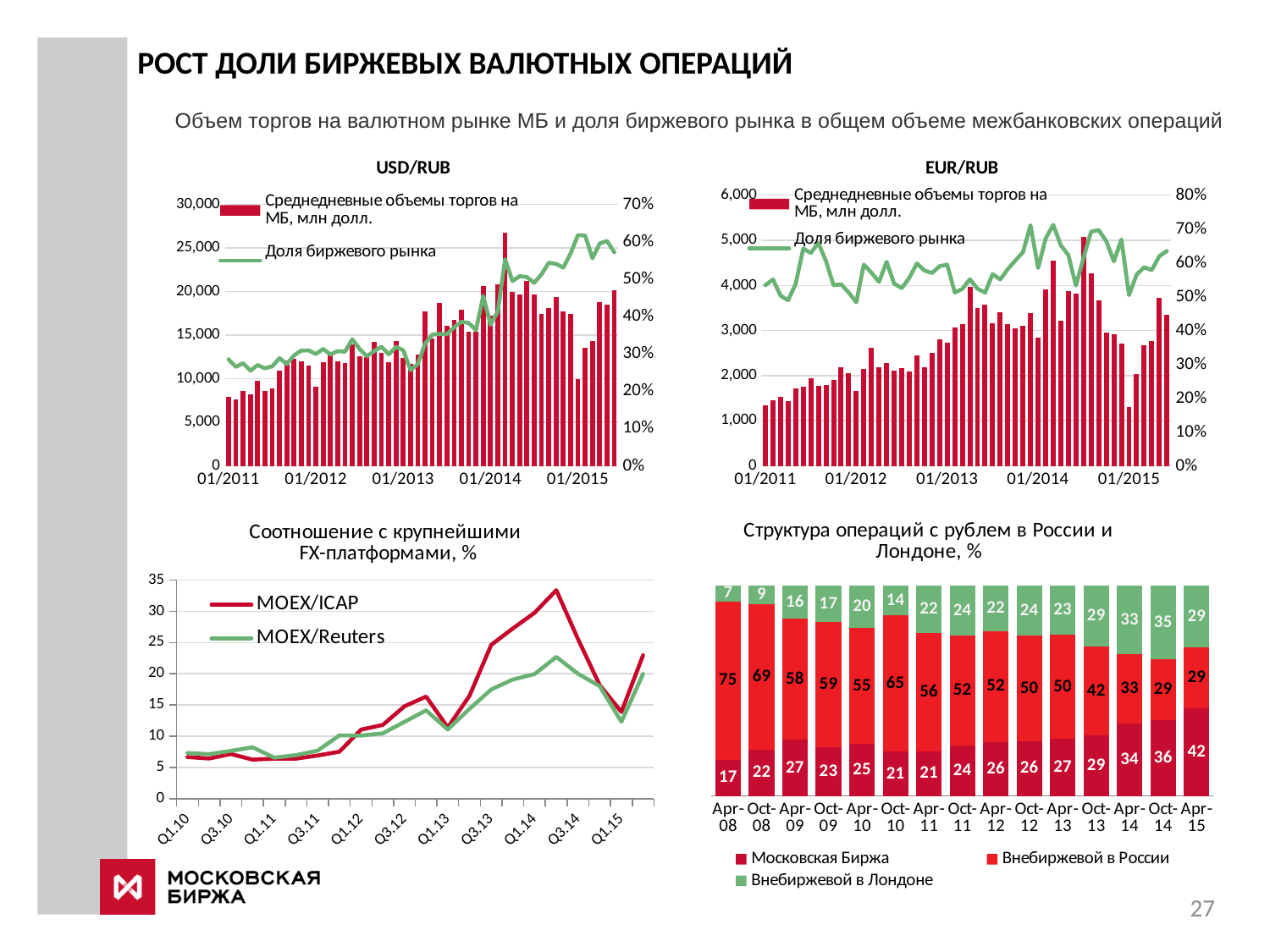
In the chart 'Структура операций с рублем в России и Лондоне, %', what is the difference between the Внебиржевой в России value in Apr-08 and in Apr-15? 46 In the chart 'Структура операций с рублем в России и Лондоне, %', what is the value for Внебиржевой в Лондоне in Apr-08? 7 How many series does the legend of the chart 'Соотношение с крупнейшими FX-платформами, %' list? 2 In the chart 'Структура операций с рублем в России и Лондоне, %', which period has the highest value for Московская Биржа? Apr-15 In the chart 'Структура операций с рублем в России и Лондоне, %', what is the value for Московская Биржа in Apr-15? 42 In the chart 'Структура операций с рублем в России и Лондоне, %', which period has the lowest value for Внебиржевой в Лондоне? Apr-08 In the chart 'Структура операций с рублем в России и Лондоне, %', which is larger in Apr-09: Московская Биржа or Внебиржевой в Лондоне? Московская Биржа In the chart 'Структура операций с рублем в России и Лондоне, %', does the Московская Биржа value generally rise or fall from Apr-08 to Apr-15? Rise How many periods are shown on the x axis of the chart 'Структура операций с рублем в России и Лондоне, %'? 15 In the EUR/RUB chart, is the average daily trading volume bar at 01/2011 greater or less than 2,000? less How many series does the legend of the chart 'Структура операций с рублем в России и Лондоне, %' list? 3 What kind of chart is 'Структура операций с рублем в России и Лондоне, %'? Stacked bar chart